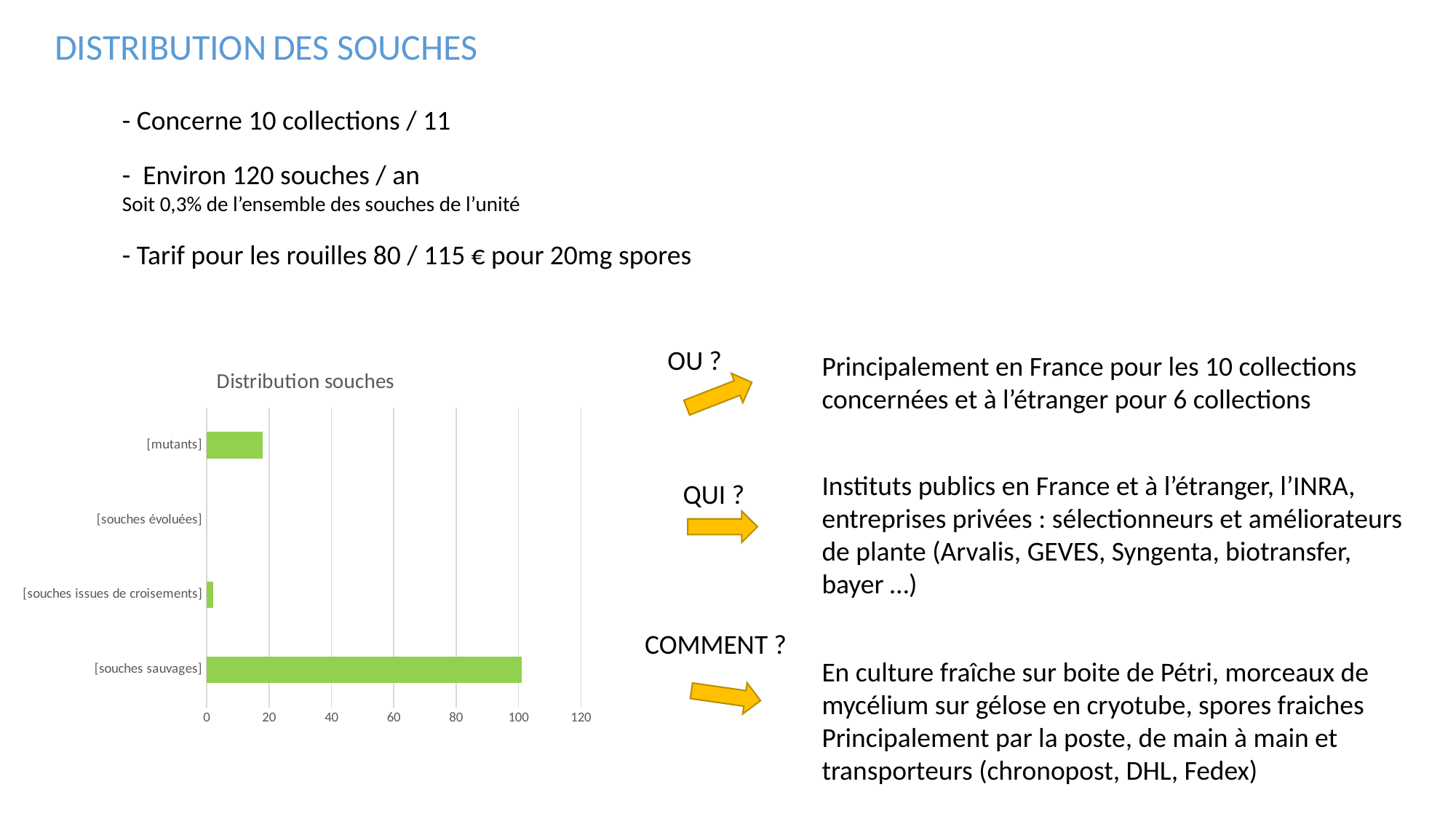
How many categories are plotted in the chart? 4 Which category has the lowest value in the chart? [souches évoluées] Which is larger, the value for [mutants] or the value for [souches issues de croisements]? [mutants] Is the value for [mutants] greater or less than 10? greater Is the value for [souches sauvages] greater or less than 80? greater Is the value for [mutants] greater or less than 40? less Which is larger, the value for [souches sauvages] or the value for [mutants]? [souches sauvages] What kind of chart is shown on the slide? bar chart What is the title of the chart? Distribution souches Which category has the highest value in the chart? [souches sauvages] What colour are the bars in the chart? green